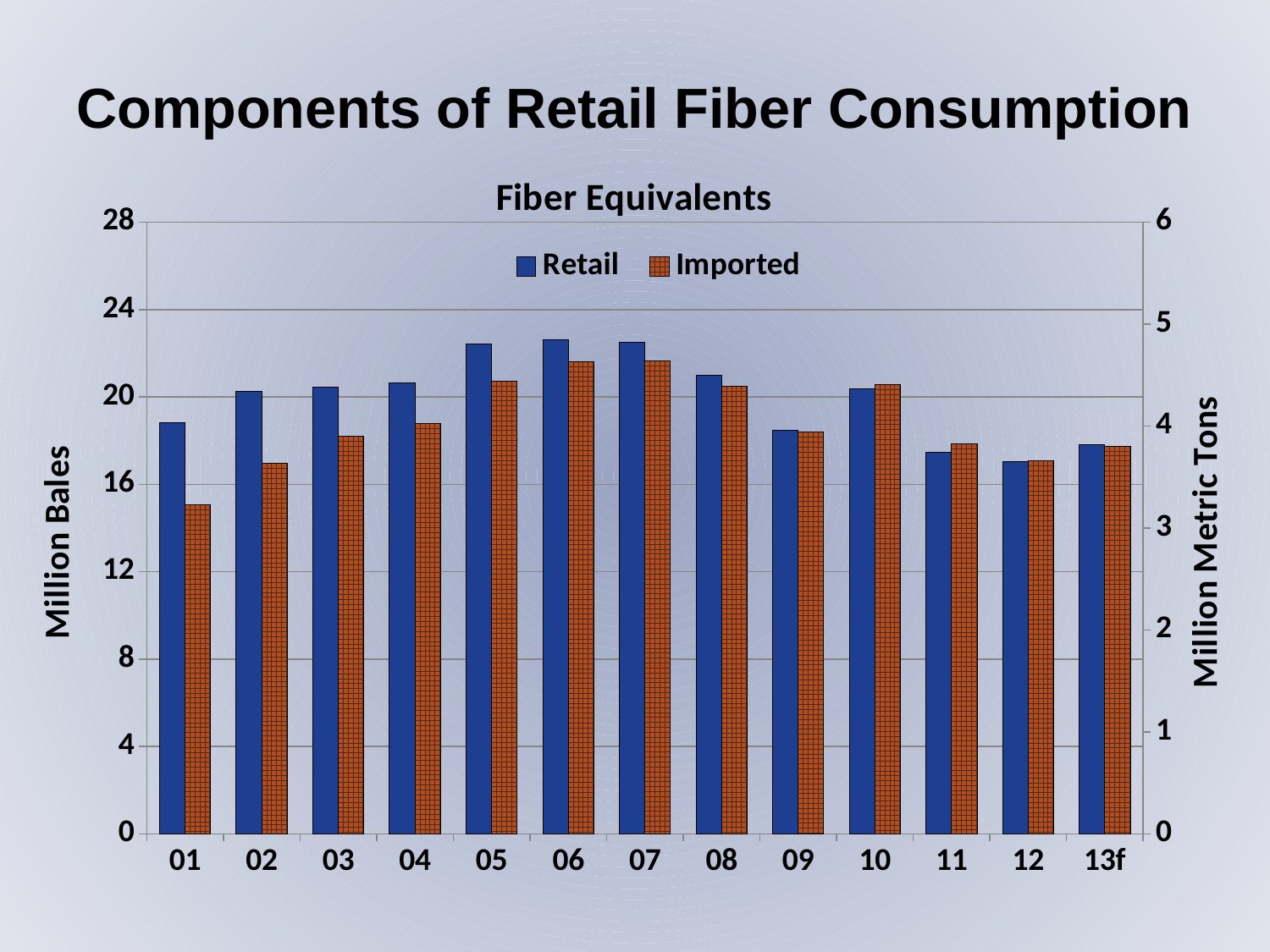
In 02, which is larger, Retail or Imported? Retail Is the Imported value for 12 greater or less than 20 million bales? less Which category has the lowest Imported value? 01 Is the Imported value for 01 greater or less than 16 million bales? less Do the Imported values rise or fall from 01 to 06? rise What kind of chart is shown on the slide? bar chart Is the Retail value for 06 greater or less than 20 million bales? greater How many categories are shown along the x axis? 13 In 01, which is larger, Retail or Imported? Retail How many series does the chart legend list? 2 What is the label on the left vertical axis? Million Bales